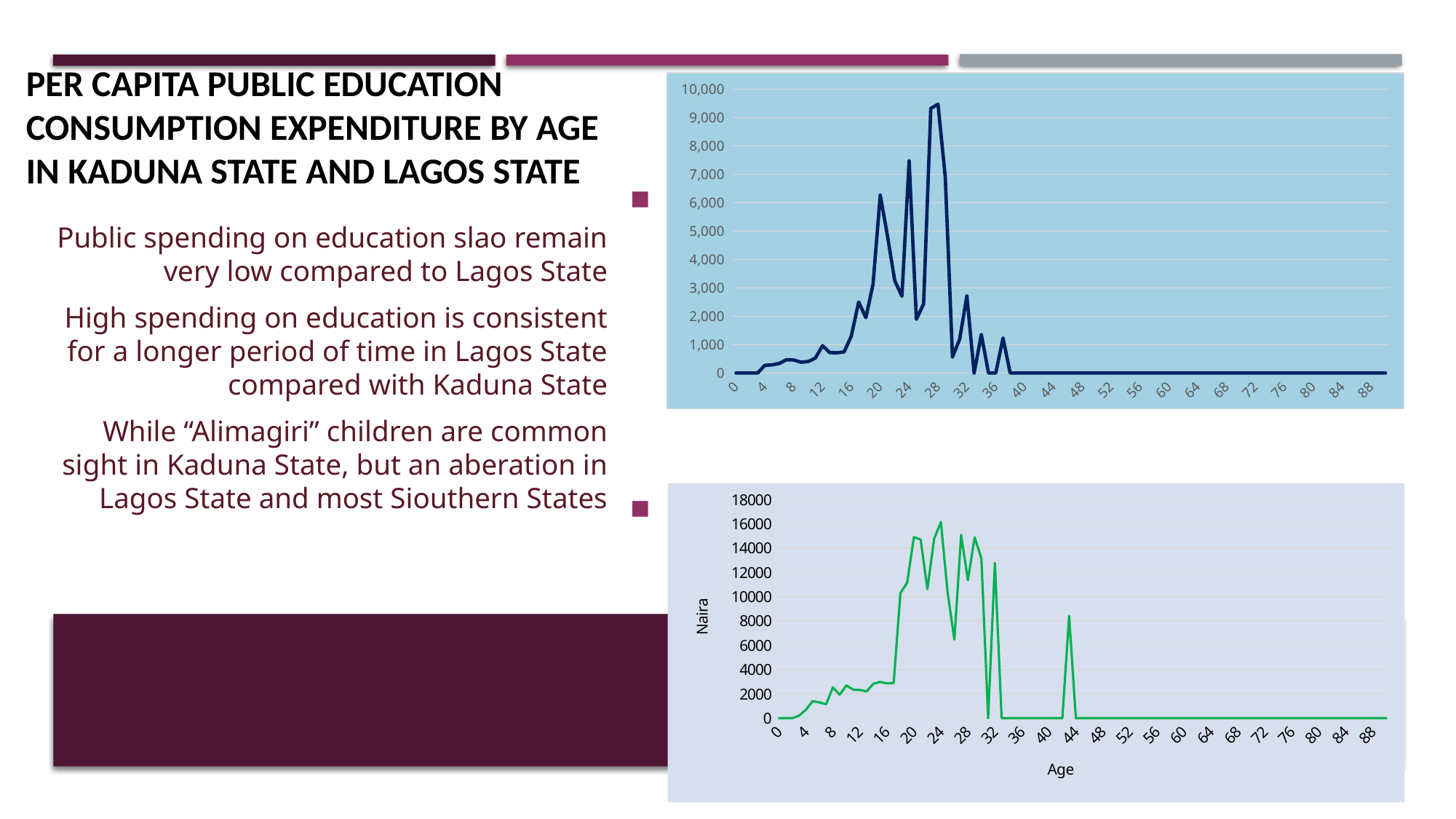
In the bottom chart, is the value of the spike around age 44 greater or less than 6000? greater In the top chart, is the value at age 60 greater or less than 1,000? less In the bottom chart, is the highest value of the line (around age 24) greater or less than 14000? greater In the bottom chart, do the values generally rise or fall between age 0 and age 20? rise What kind of chart is the top chart on the slide? line chart What is the label on the horizontal axis of the bottom chart? Age In the bottom chart, which is higher: the peak around age 24 or the spike around age 44? the peak around age 24 What is the label on the vertical axis of the bottom chart? Naira What kind of chart is the bottom chart on the slide? line chart In the top chart, which is higher: the peak around age 20 or the peak around age 28? the peak around age 28